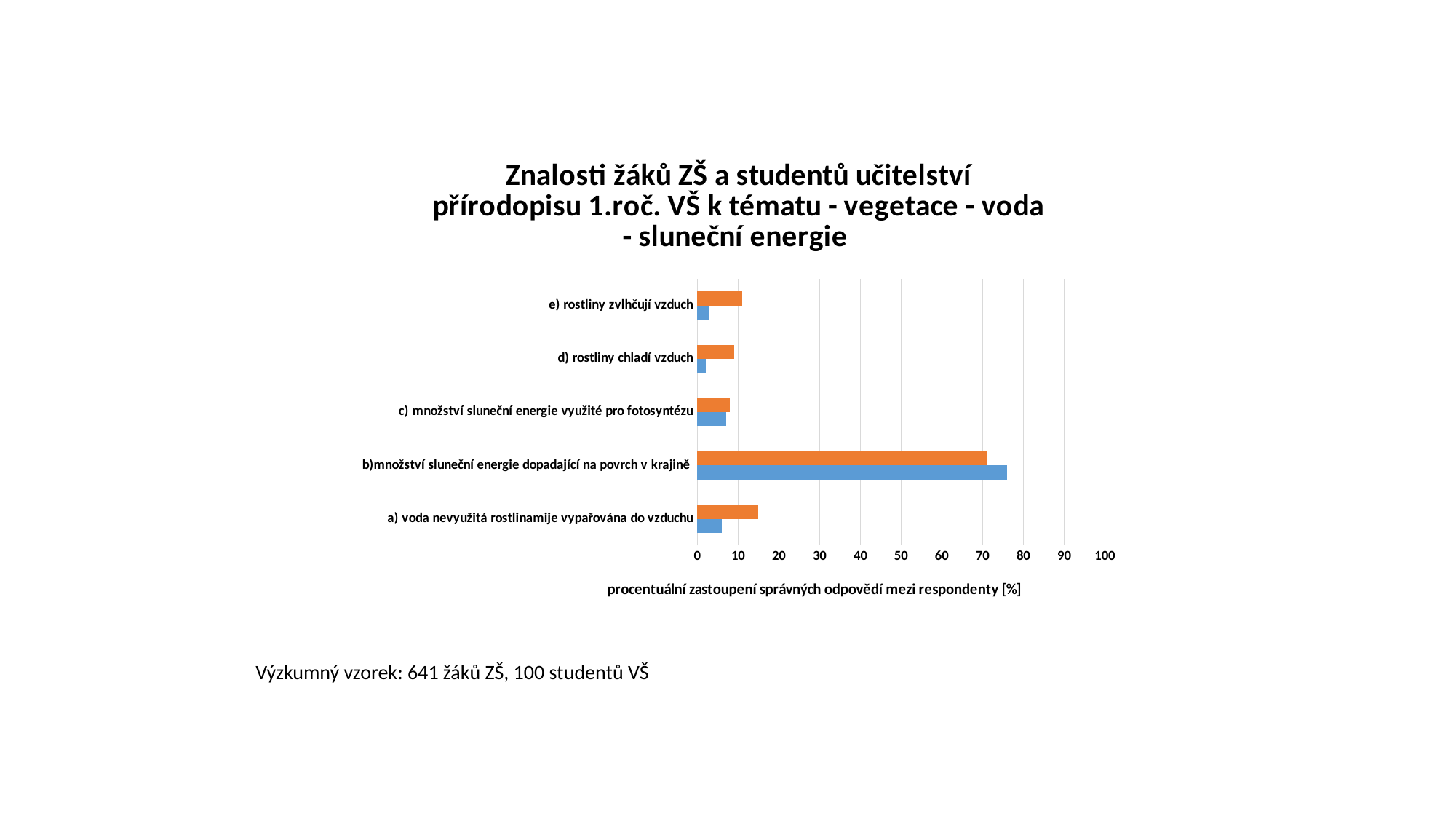
What kind of chart is shown on the slide? bar chart Which category has the highest values on the chart? b)množství sluneční energie dopadající na povrch v krajině What is the label of the horizontal axis of the chart? procentuální zastoupení správných odpovědí mezi respondenty [%] For 'b)množství sluneční energie dopadající na povrch v krajině', which bar is longer, the orange one or the blue one? blue For 'e) rostliny zvlhčují vzduch', which bar is longer, the orange one or the blue one? orange Is the blue bar for 'e) rostliny zvlhčují vzduch' greater or less than 10? less Is the orange bar for 'b)množství sluneční energie dopadající na povrch v krajině' greater or less than 80? less Is the blue bar for 'b)množství sluneční energie dopadající na povrch v krajině' greater or less than 70? greater What is the maximum value shown on the horizontal axis of the chart? 100 How many categories (answer options) are plotted on the chart? 5